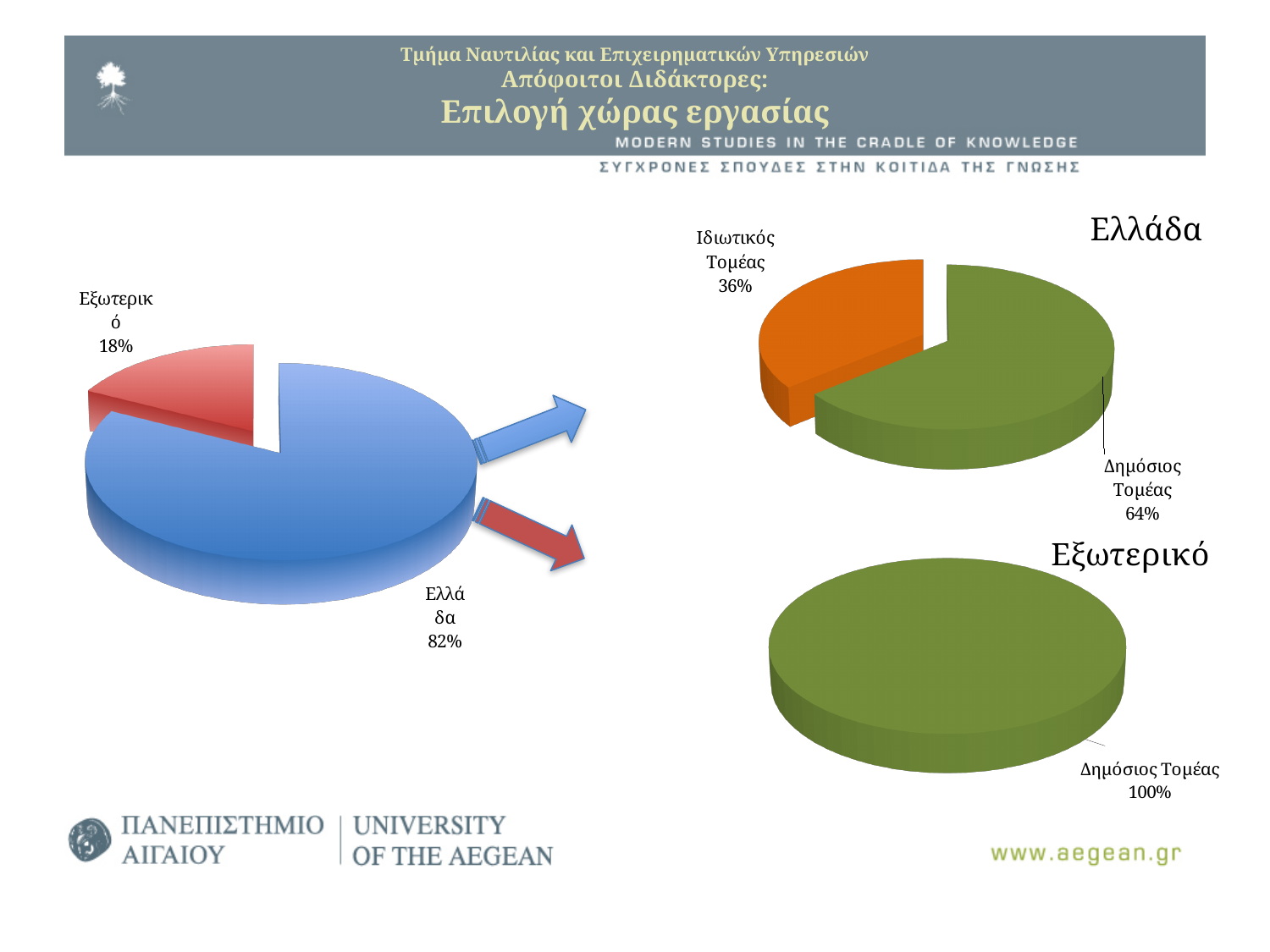
In the pie chart titled Ελλάδα, what share is labelled for Δημόσιος Τομέας? 64% How many pie charts are shown on the slide? 3 In the left pie chart, which slice is larger, Ελλάδα or Εξωτερικό? Ελλάδα In the pie chart titled Ελλάδα, what is the difference in percentage points between Δημόσιος Τομέας and Ιδιωτικός Τομέας? 28 In the pie chart titled Εξωτερικό, what share is labelled for Δημόσιος Τομέας? 100% In the pie chart titled Ελλάδα, which sector has the largest slice? Δημόσιος Τομέας In the left pie chart, what share is labelled for Ελλάδα? 82% How many slices does the left pie chart have? 2 In the left pie chart, what is the difference in percentage points between the Ελλάδα and Εξωτερικό slices? 64 What kind of chart is the chart titled Εξωτερικό? Pie chart